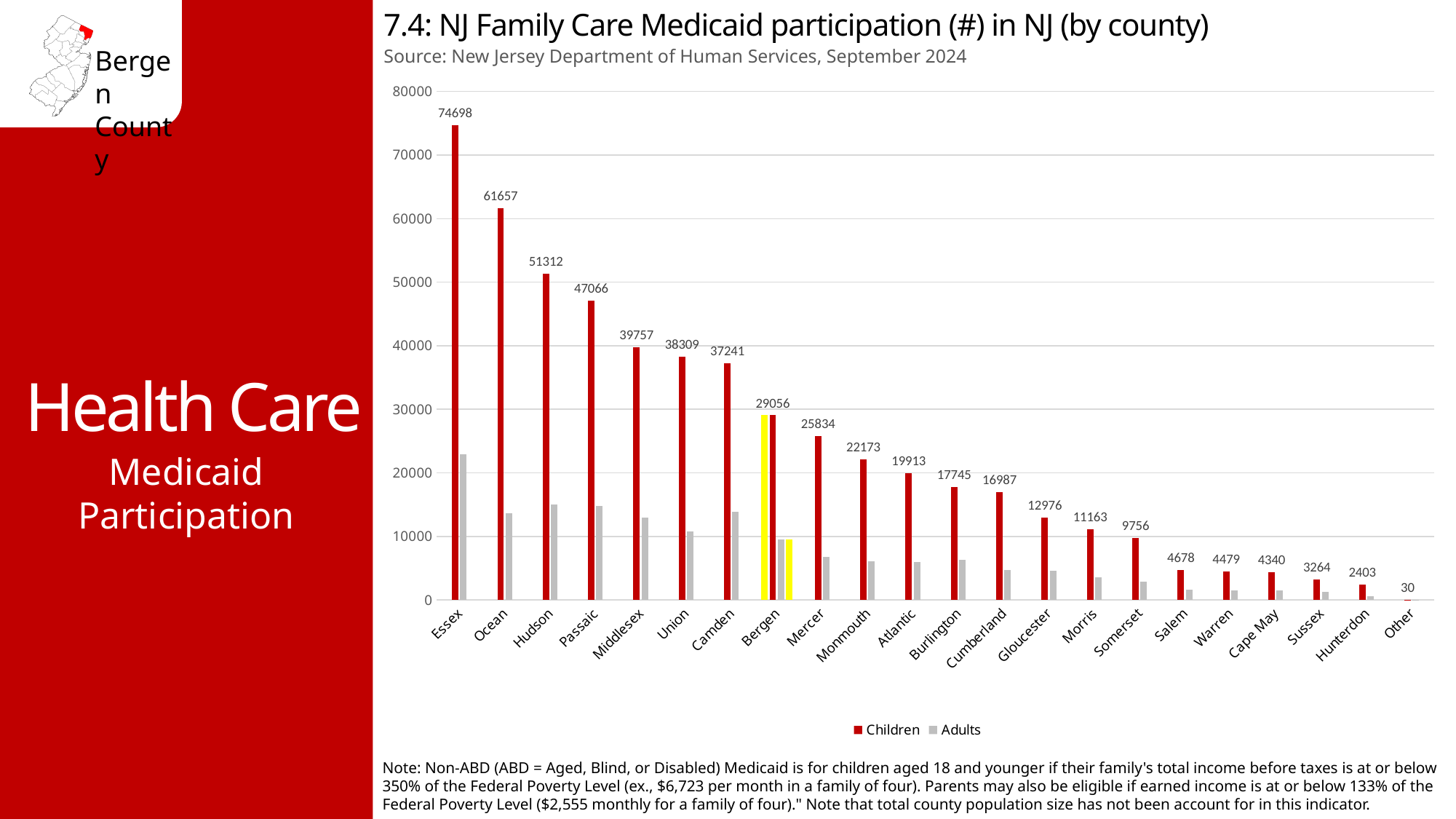
What is the Children value for Bergen? 29056 How many categories are shown on the x axis? 22 What is the Children value for Essex? 74698 How many series does the legend list? 2 What kind of chart is shown on the slide? bar chart Which has a larger Children value, Hudson or Passaic? Hudson Which county has the highest Children value? Essex Do the Children values rise or fall from left to right along the x axis? fall Is the Adults value for Ocean greater or less than 10000? greater Which category has the lowest Children value? Other What is the difference between the Children values for Essex and Ocean? 13041 What is the Children value for Somerset? 9756